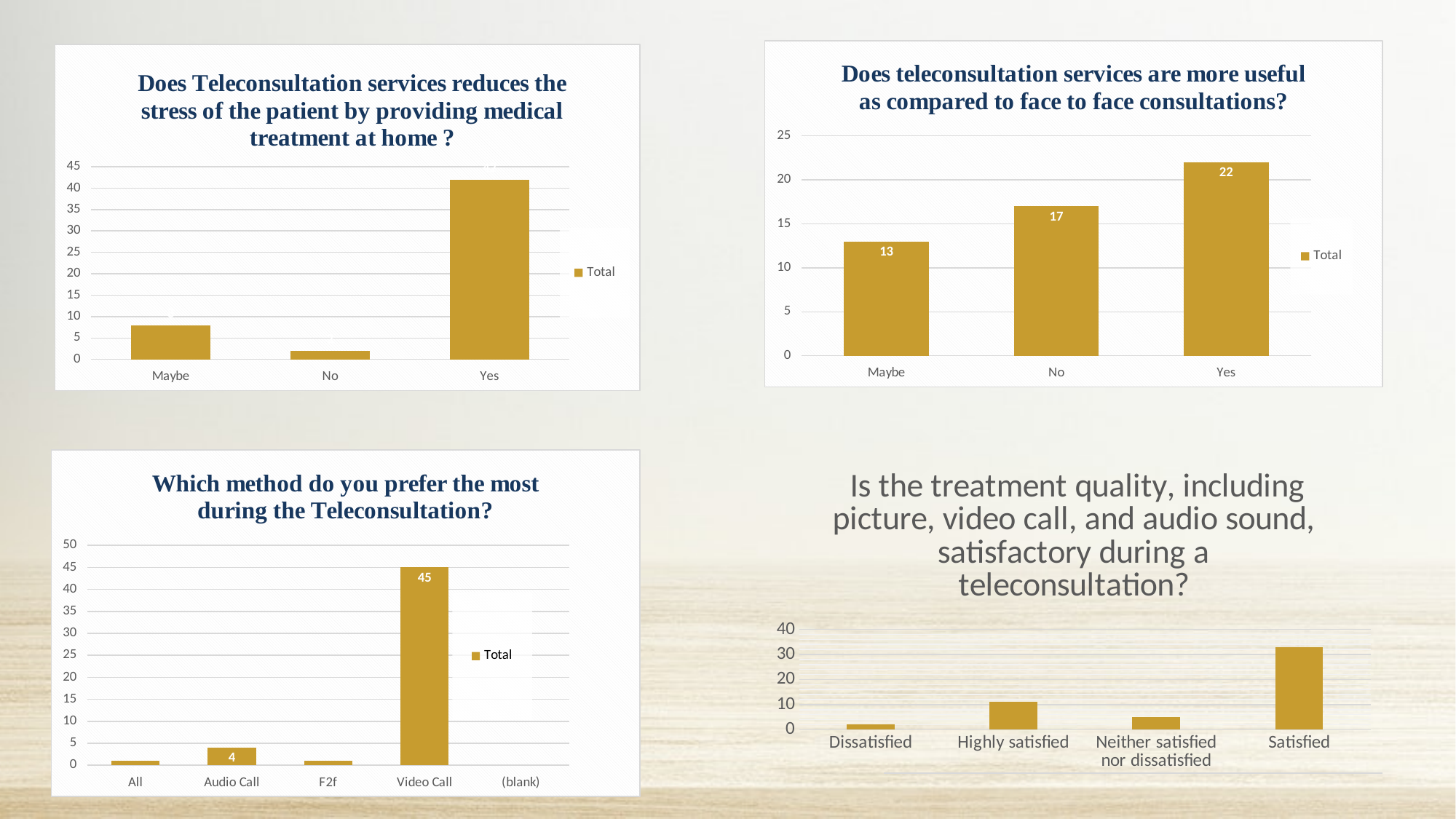
In the chart titled "Which method do you prefer the most during the Teleconsultation?", what is the value for Video Call? 45 In the top-left chart about reducing the stress of the patient, is the value for Maybe greater or less than 10? less In the chart titled "Does teleconsultation services are more useful as compared to face to face consultations?", what is the value for Yes? 22 In the top-left chart about reducing the stress of the patient, which category has the highest value? Yes In the chart titled "Does teleconsultation services are more useful as compared to face to face consultations?", which category has the lowest value? Maybe In the bottom-right chart about treatment quality, is the value for Satisfied greater or less than 30? greater In the chart titled "Does teleconsultation services are more useful as compared to face to face consultations?", what is the difference between the values for Yes and No? 5 In the chart titled "Which method do you prefer the most during the Teleconsultation?", what is the value for Audio Call? 4 In the chart titled "Does teleconsultation services are more useful as compared to face to face consultations?", what is the value for Maybe? 13 How many categories are shown on the x axis of the chart titled "Which method do you prefer the most during the Teleconsultation?"? 5 In the bottom-right chart about treatment quality, which category has the highest value? Satisfied In the top-left chart about reducing the stress of the patient, is the value for Yes greater or less than 40? greater